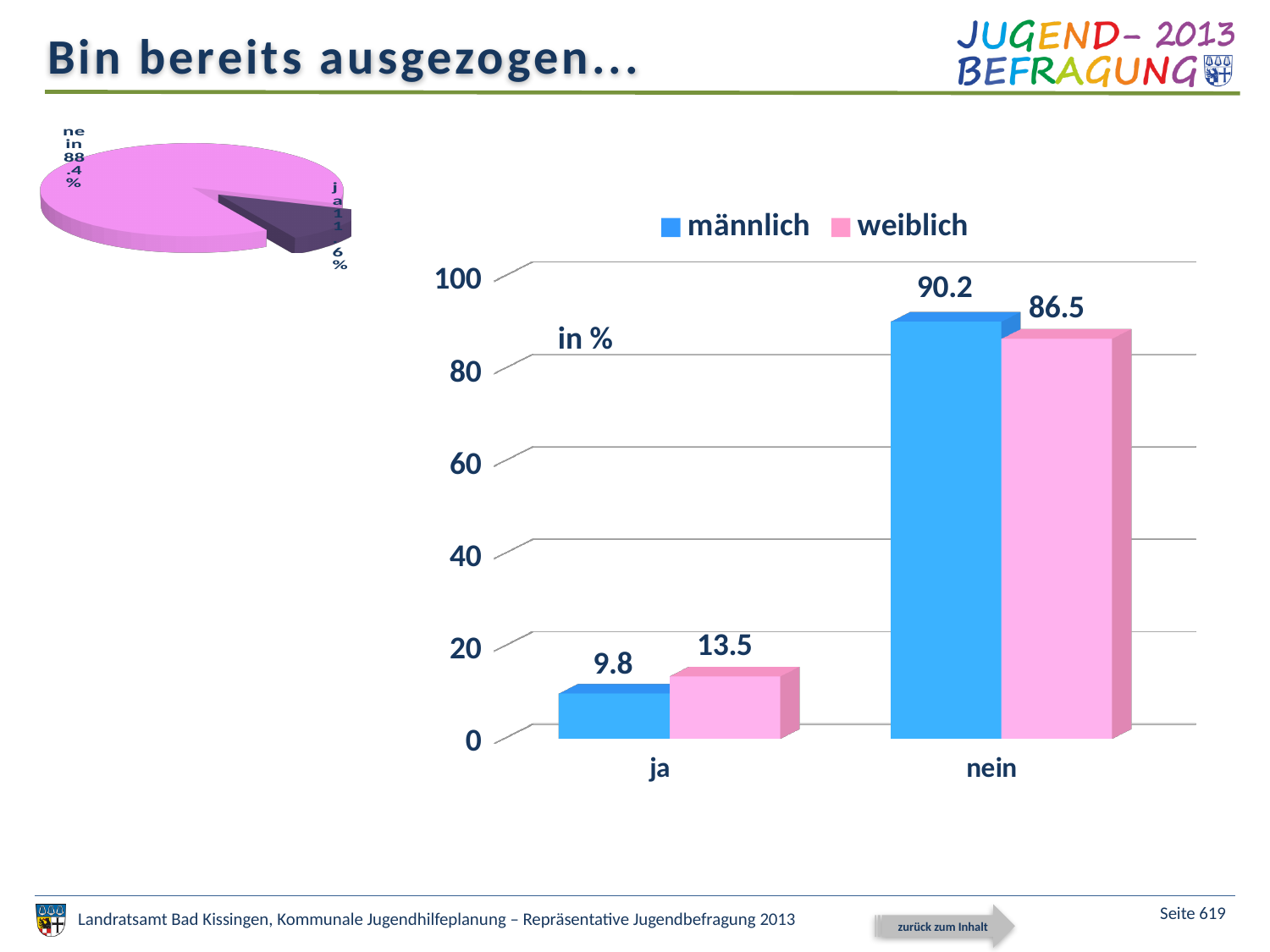
In the bar chart on the right, what is the difference between the männlich and weiblich values in the category nein? 3.7 In the bar chart on the right, which category has the highest value for männlich? nein In the bar chart on the right, how many series does the legend list? 2 In the bar chart on the right, which category has the lowest value for weiblich? ja What kind of chart is the chart on the right of the slide? bar chart In the bar chart on the right, which is larger in the category ja: männlich or weiblich? weiblich In the pie chart on the left, what share does the nein slice have? 88.4% In the bar chart on the right, what is the value for männlich in the category ja? 9.8 In the bar chart on the right, what is the value for weiblich in the category ja? 13.5 In the bar chart on the right, how many categories are shown on the x axis? 2 In the bar chart on the right, what is the value for weiblich in the category nein? 86.5 In the bar chart on the right, what is the value for männlich in the category nein? 90.2